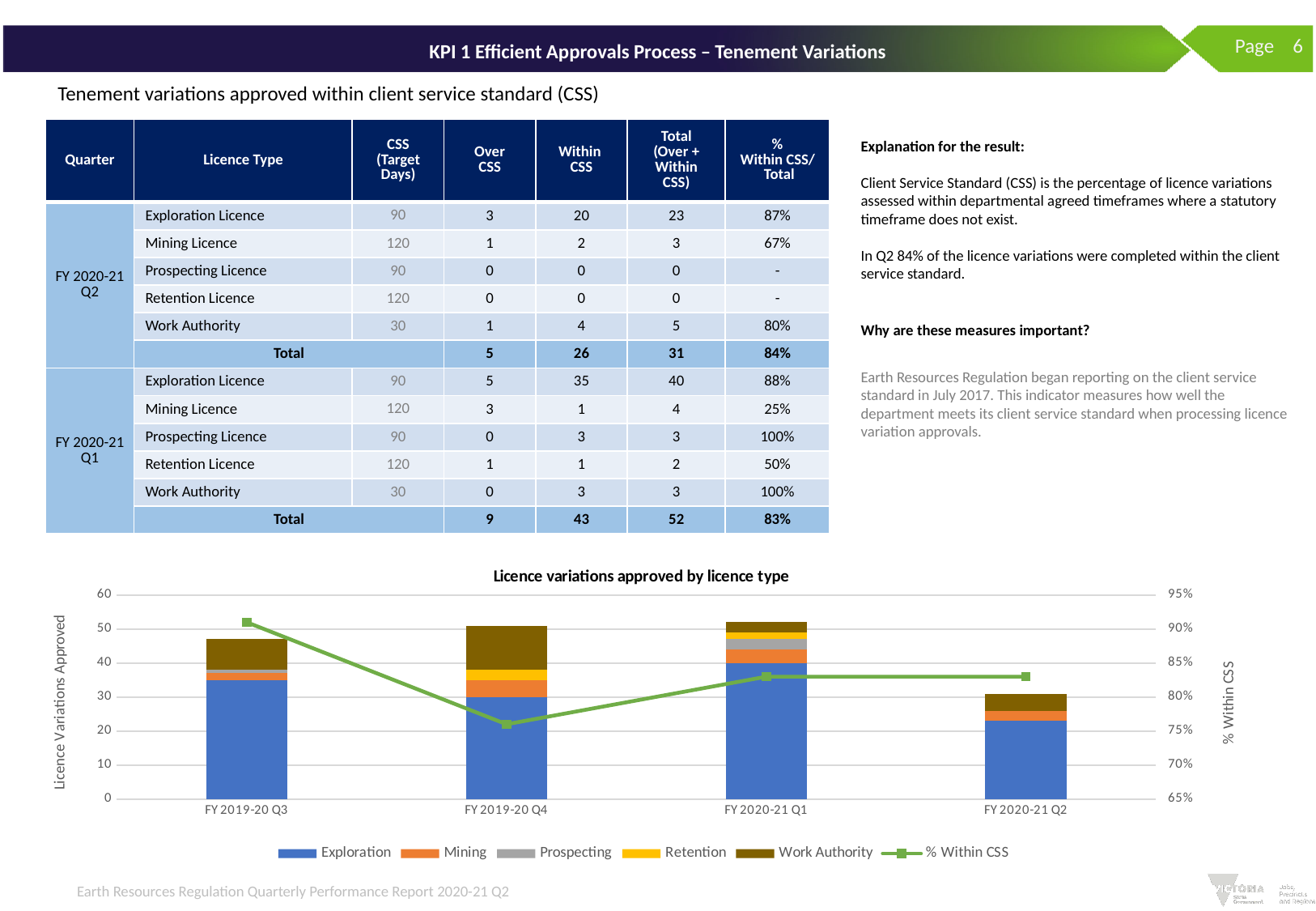
How many quarters are shown on the x axis of the 'Licence variations approved by licence type' chart? 4 In the 'Licence variations approved by licence type' chart, is the % Within CSS for FY 2019-20 Q3 greater or less than 85%? greater What is the label of the right-hand vertical axis of the 'Licence variations approved by licence type' chart? % Within CSS In the 'Licence variations approved by licence type' chart, which total bar is larger: FY 2019-20 Q3 or FY 2020-21 Q2? FY 2019-20 Q3 In the 'Licence variations approved by licence type' chart, is the % Within CSS for FY 2019-20 Q4 greater or less than 80%? less What kind of chart is 'Licence variations approved by licence type'? bar chart with a line In the 'Licence variations approved by licence type' chart, which quarter has the lowest total bar? FY 2020-21 Q2 In the 'Licence variations approved by licence type' chart, does the % Within CSS line rise or fall from FY 2019-20 Q3 to FY 2019-20 Q4? fall In the 'Licence variations approved by licence type' chart, which quarter has the lowest % Within CSS? FY 2019-20 Q4 In the 'Licence variations approved by licence type' chart, is the total bar for FY 2020-21 Q2 greater or less than 40? less How many series does the legend of the 'Licence variations approved by licence type' chart list? 6 In the 'Licence variations approved by licence type' chart, which quarter has the highest % Within CSS? FY 2019-20 Q3